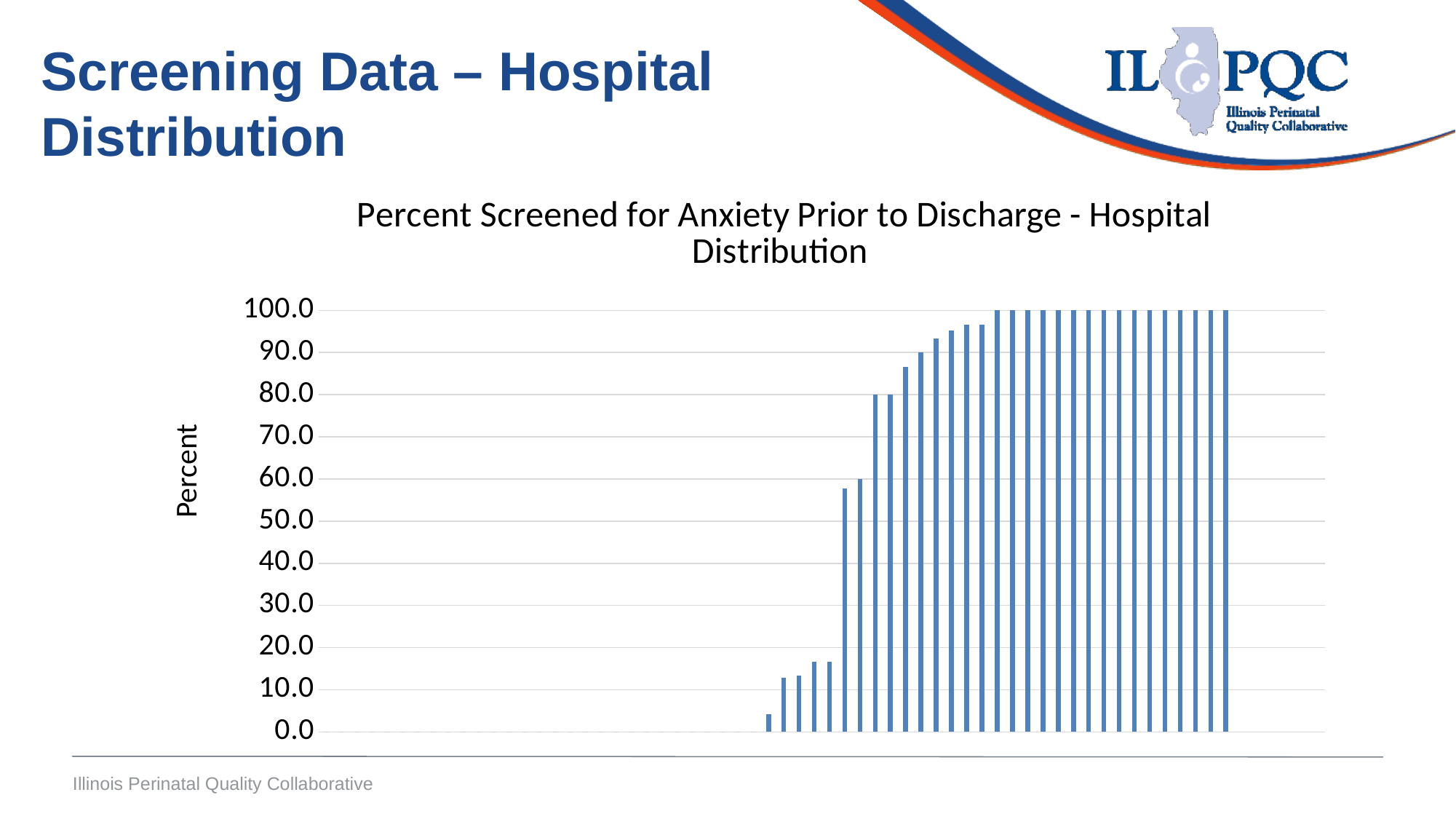
Is the value of the leftmost bar greater or less than 10.0? less What is the highest value shown on the vertical axis? 100.0 What value does the rightmost bar reach? 100.0 What is the title of the chart? Percent Screened for Anxiety Prior to Discharge - Hospital Distribution Is the value of the sixth bar from the left greater or less than 50.0? greater Do the bar values rise or fall from left to right across the chart? rise What kind of chart is shown on the slide? bar chart What is the label on the vertical axis of the chart? Percent Is the value of the second bar from the left greater or less than 20.0? less Which is larger, the leftmost bar or the rightmost bar? the rightmost bar What is the value of the tallest bars in the chart? 100.0